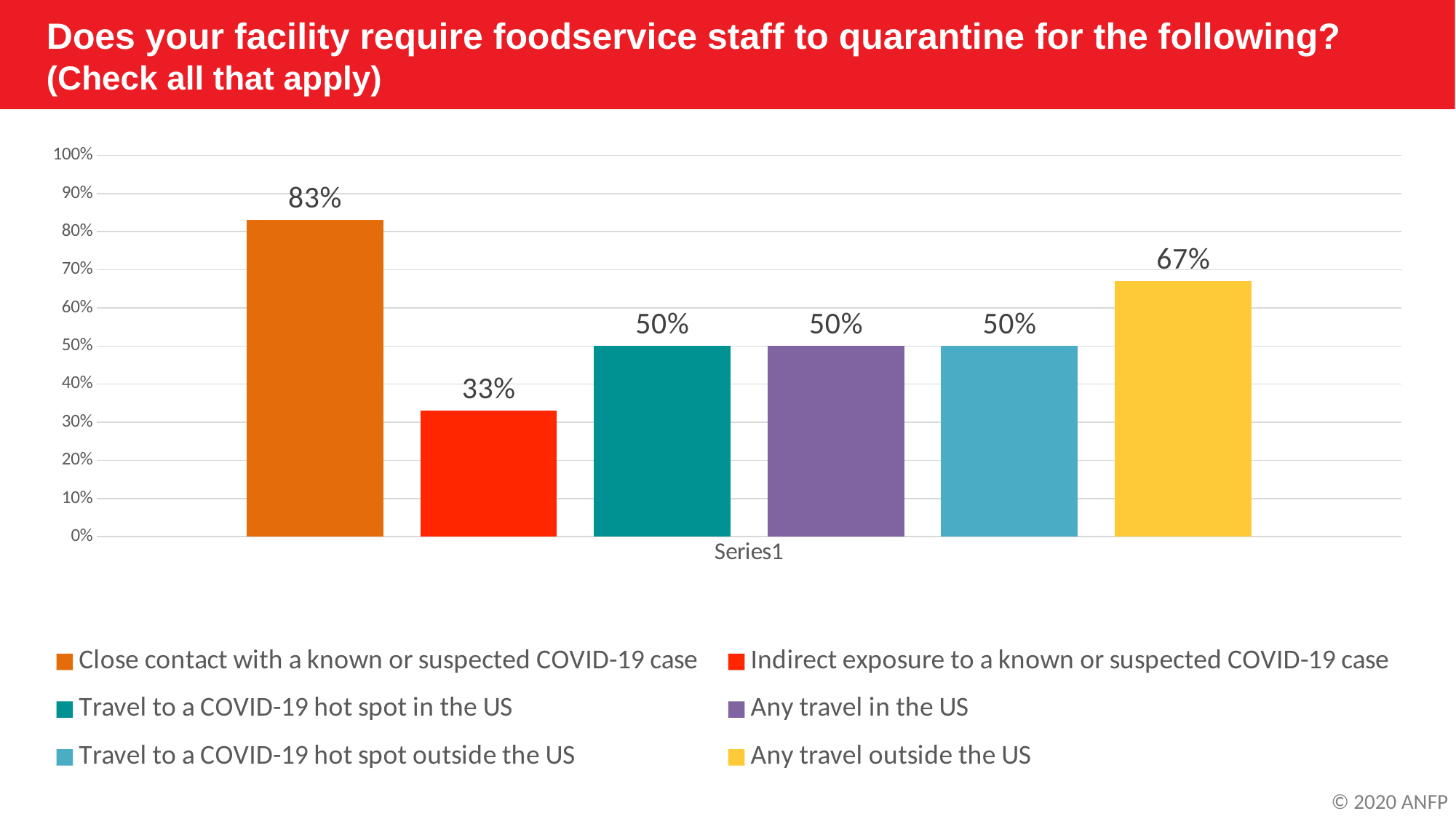
What percentage of facilities require quarantine for any travel outside the US? 67% What is the difference in percentage points between any travel outside the US and any travel in the US? 17 percentage points What percentage of facilities require quarantine for travel to a COVID-19 hot spot in the US? 50% How many entries does the legend list? 6 How many bars are shown in the chart? 6 Which quarantine reason has the highest percentage? Close contact with a known or suspected COVID-19 case What type of chart is shown on the slide? Bar chart What percentage of facilities require quarantine for close contact with a known or suspected COVID-19 case? 83% Which quarantine reason has the lowest percentage? Indirect exposure to a known or suspected COVID-19 case Which is larger: the value for any travel outside the US or the value for travel to a COVID-19 hot spot outside the US? Any travel outside the US What is the difference in percentage points between close contact with a known or suspected COVID-19 case and indirect exposure to a known or suspected COVID-19 case? 50 percentage points What percentage of facilities require quarantine for indirect exposure to a known or suspected COVID-19 case? 33%